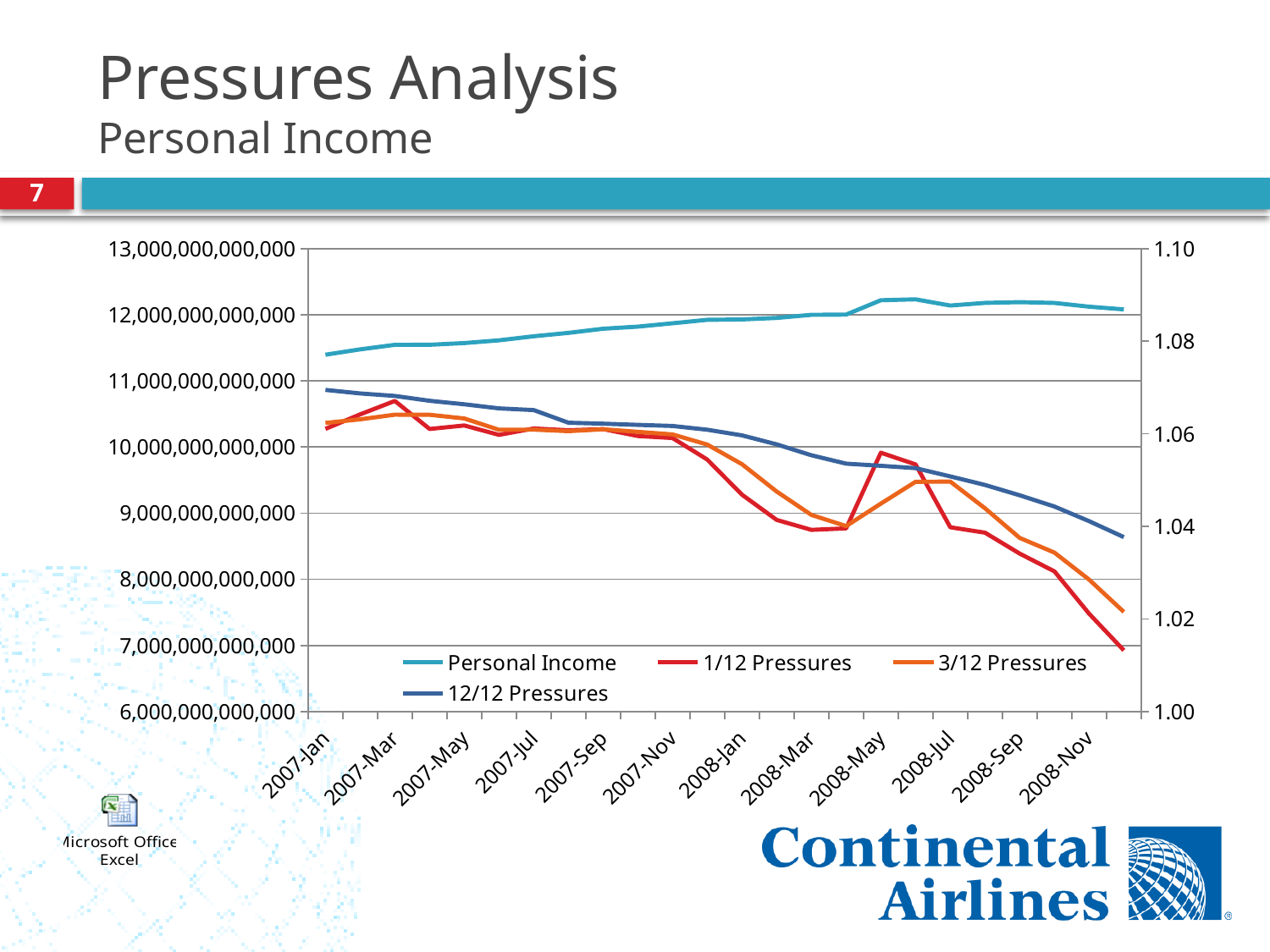
Which of the three Pressures series is lowest at 2008-Nov? 1/12 Pressures Does the Personal Income line generally rise or fall from 2007-Jan to 2008-Nov? Rise What colour is the 1/12 Pressures line? Red Does the 12/12 Pressures line rise or fall from 2007-Jan to 2008-Nov? Fall Which series are listed in the chart's legend? Personal Income, 1/12 Pressures, 3/12 Pressures, 12/12 Pressures Is the Personal Income value at 2007-Jan greater or less than 11,000,000,000,000? greater On the right-hand axis, is the 12/12 Pressures value at 2007-Jan greater or less than 1.06? greater How many series does the chart's legend list? 4 What kind of chart is shown on the slide? Line chart At 2008-Nov, which is higher: the 1/12 Pressures line or the 3/12 Pressures line? 3/12 Pressures Is the Personal Income value at 2008-May greater or less than 12,000,000,000,000? greater